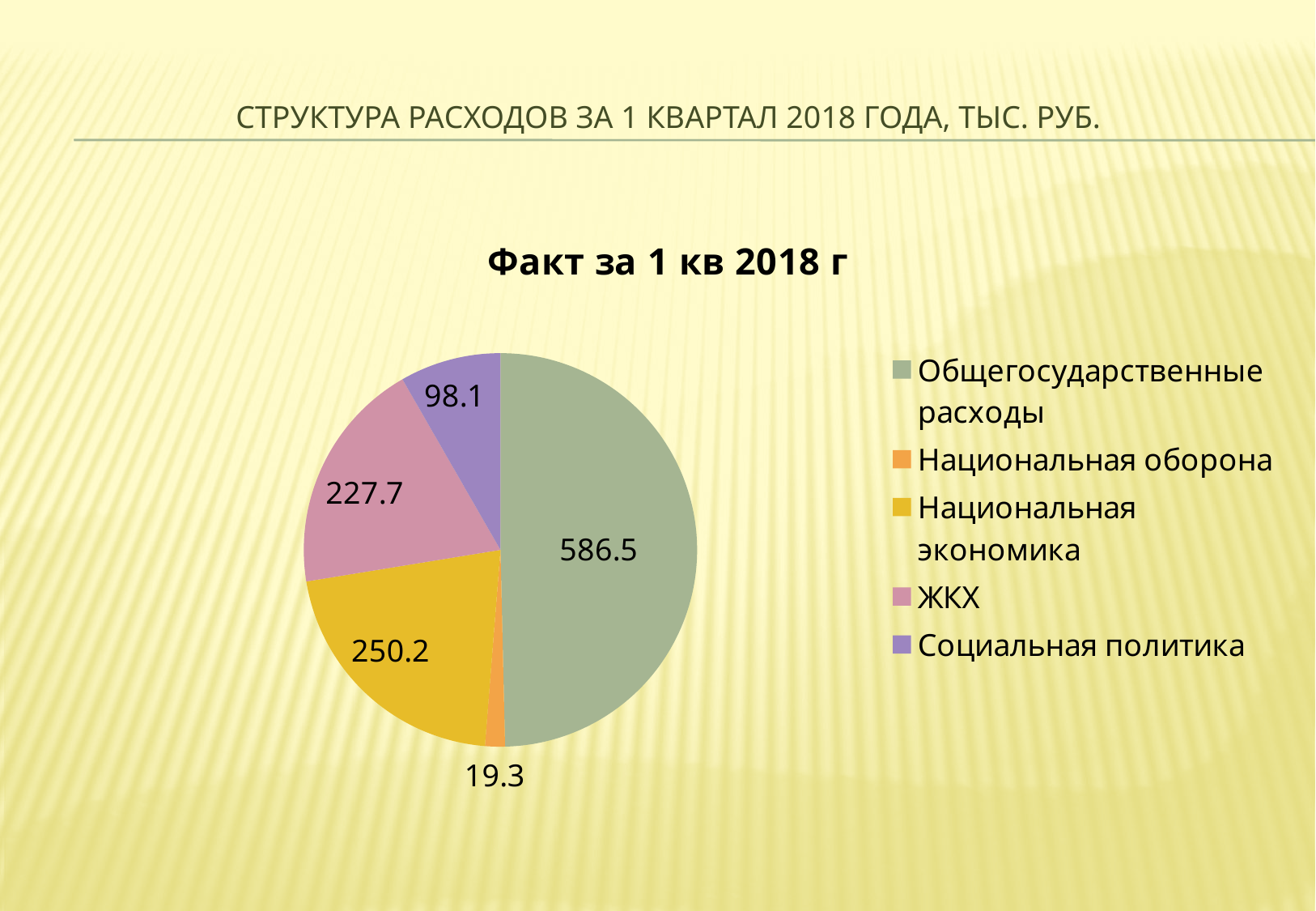
What is the value for Социальная политика? 98.1 Which category has the largest slice of the pie? Общегосударственные расходы What is the value for Национальная оборона? 19.3 What type of chart is shown on the slide? pie chart What is the value for ЖКХ? 227.7 What is the difference between the values for Национальная экономика and ЖКХ? 22.5 Which is larger, the value for ЖКХ or the value for Социальная политика? ЖКХ What is the value for Общегосударственные расходы? 586.5 How many categories does the pie chart show? 5 What is the value for Национальная экономика? 250.2 What is the title of the pie chart? Факт за 1 кв 2018 г Which category has the smallest slice of the pie? Национальная оборона